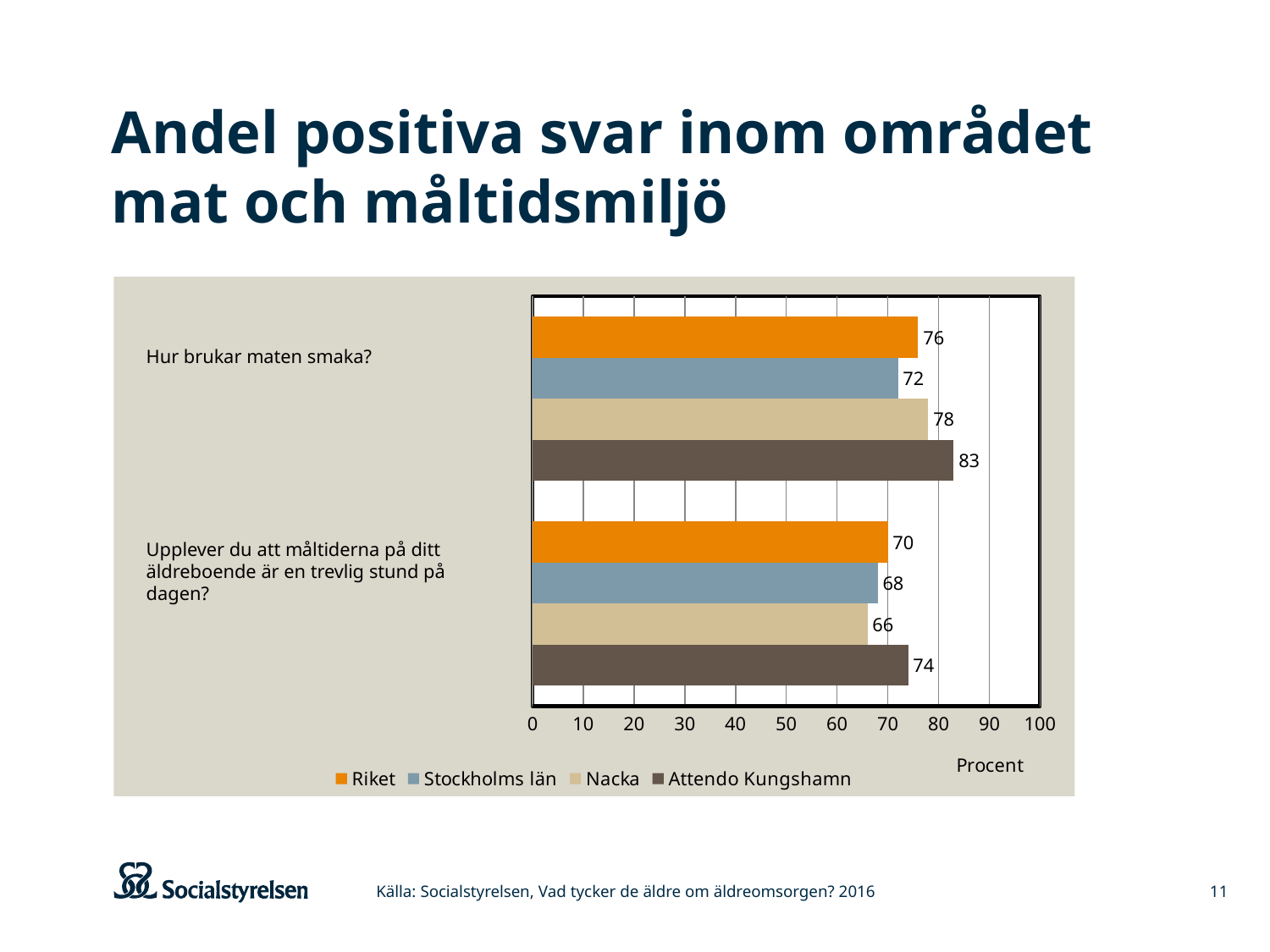
What kind of chart is shown on the slide? Bar chart How many questions (categories) are shown on the chart? 2 What is the value for Stockholms län for the question "Upplever du att måltiderna på ditt äldreboende är en trevlig stund på dagen?"? 68 What is the difference between the Attendo Kungshamn and Riket values for "Hur brukar maten smaka?"? 7 What is the value for Riket for the question "Hur brukar maten smaka?"? 76 Which series has the lowest value for "Upplever du att måltiderna på ditt äldreboende är en trevlig stund på dagen?"? Nacka What unit is shown on the horizontal axis of the chart? Procent Is the value for Nacka for "Hur brukar maten smaka?" greater or less than 70? greater Which is larger for "Upplever du att måltiderna på ditt äldreboende är en trevlig stund på dagen?": Riket or Nacka? Riket Which series has the highest value for "Hur brukar maten smaka?"? Attendo Kungshamn How many series does the legend list? 4 What is the value for Attendo Kungshamn for the question "Hur brukar maten smaka?"? 83